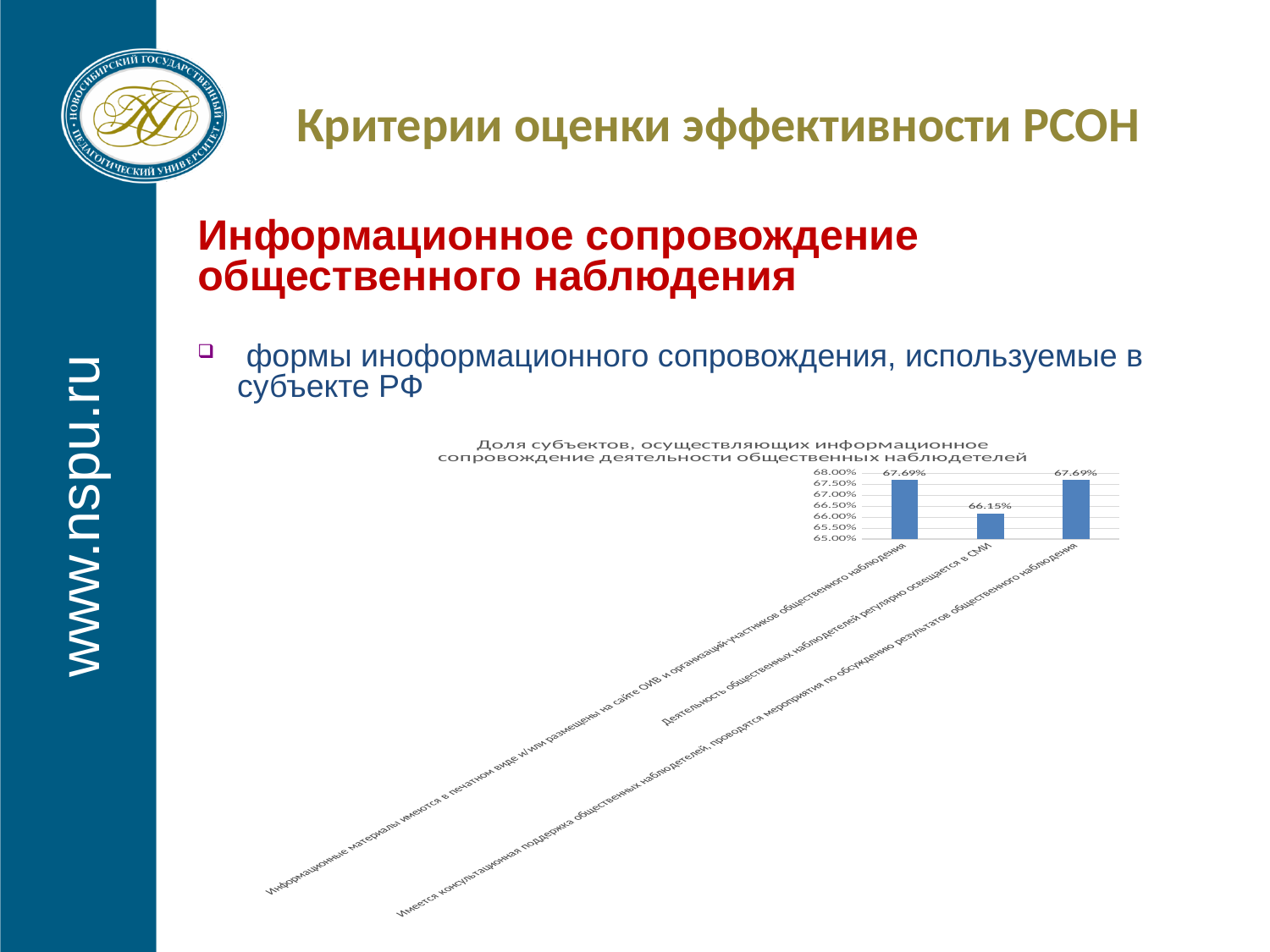
What is the value for the category about consulting support for public observers and events to discuss observation results? 67.69% What is the difference between the value for information materials in print/on the website (67.69%) and the value for coverage in the media (66.15%)? 1.54% Which is larger: the value for coverage in the media or the value for consulting support for public observers? Consulting support for public observers (67.69%) What is the value for the category about information materials being available in print and/or posted on the website of the executive authority (ОИВ)? 67.69% Which category has the lowest value? Деятельность общественных наблюдетелей регулярно освещается в СМИ What is the lowest value shown on the chart's vertical axis? 65.00% What kind of chart is shown on the slide? Bar chart Is the value for coverage in the media greater or less than 67.00%? less How many categories are shown in the chart? 3 What is the title of the chart? Доля субъектов, осуществляющих информационное сопровождение деятельности общественных наблюдетелей What is the value for the category about the activity of public observers being regularly covered in the media (СМИ)? 66.15%